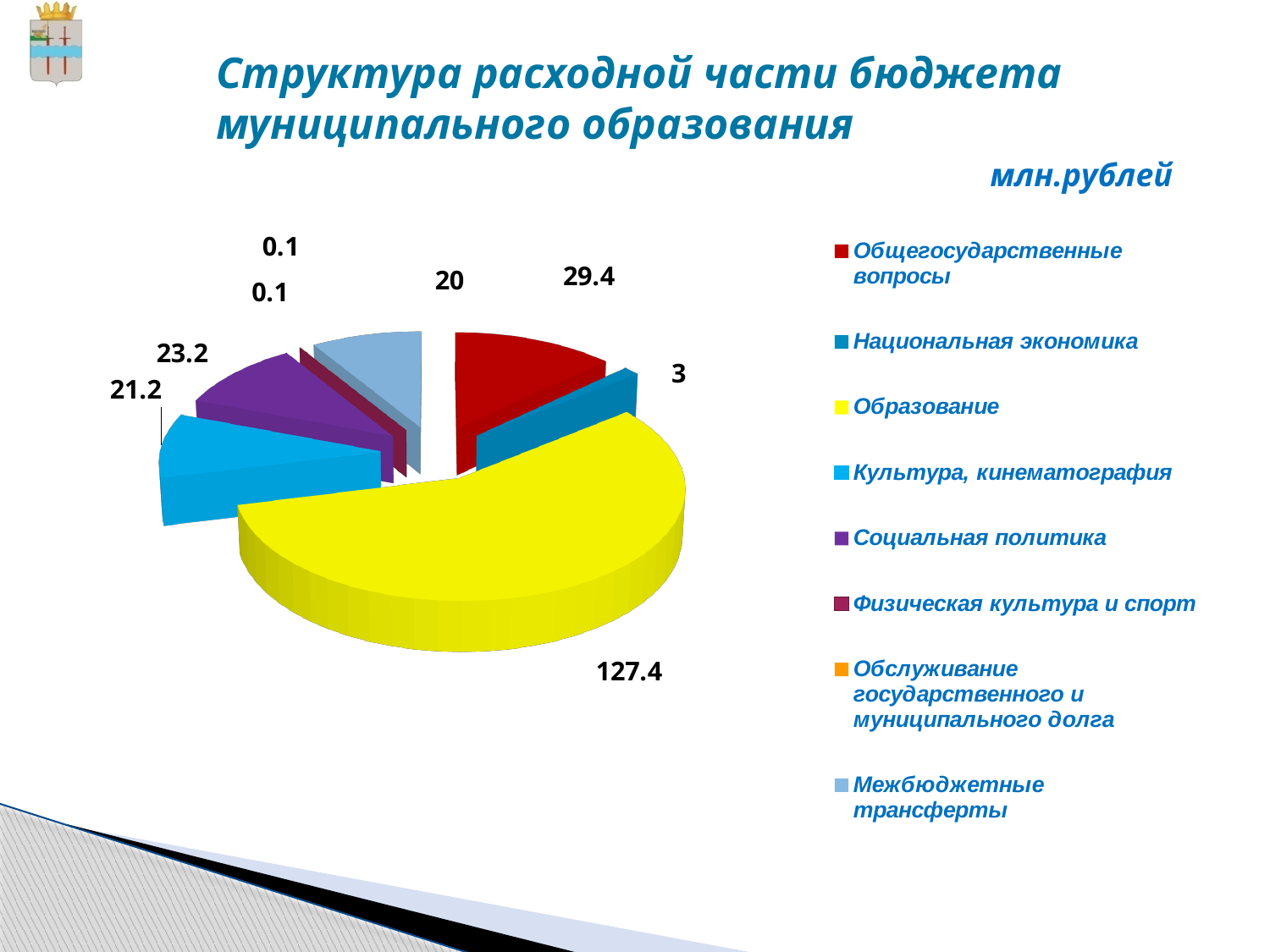
What is the value for Национальная экономика? 3 Which category has the largest slice of the pie? Образование What kind of chart is shown on the slide? pie chart In what units are the values on the chart given, according to the slide? млн.рублей What is the value for Общегосударственные вопросы? 29.4 What is the value for Культура, кинематография? 21.2 What is the difference between the values for Образование and Общегосударственные вопросы? 98 Which is larger, the value for Социальная политика or the value for Культура, кинематография? Социальная политика What is the value for Образование? 127.4 What is the value for Социальная политика? 23.2 What is the value for Межбюджетные трансферты? 20 How many categories does the legend of the pie chart list? 8